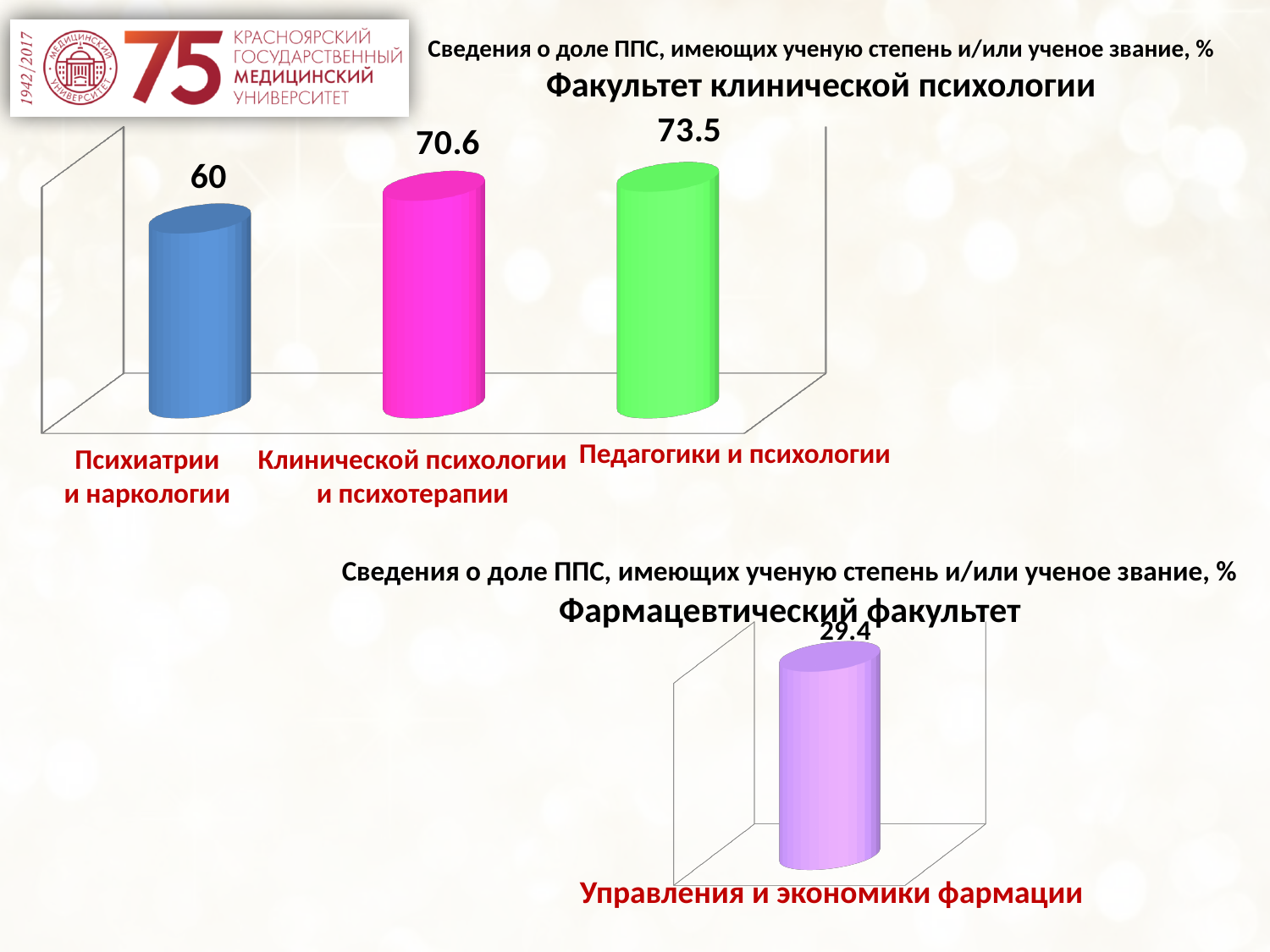
In the chart titled "Фармацевтический факультет", what is the value for Управления и экономики фармации? 29.4 In the chart titled "Факультет клинической психологии", which is larger: the value for Клинической психологии и психотерапии or for Психиатрии и наркологии? Клинической психологии и психотерапии In the chart titled "Факультет клинической психологии", which department has the highest value? Педагогики и психологии In the chart titled "Факультет клинической психологии", do the values rise or fall from left to right? rise In the chart titled "Факультет клинической психологии", what is the value for Педагогики и психологии? 73.5 What kind of chart is the chart titled "Фармацевтический факультет"? bar chart In the chart titled "Факультет клинической психологии", which department has the lowest value? Психиатрии и наркологии In the chart titled "Факультет клинической психологии", what is the value for Психиатрии и наркологии? 60 In the chart titled "Факультет клинической психологии", how many departments are shown? 3 In the chart titled "Факультет клинической психологии", what is the difference between the values for Клинической психологии и психотерапии and Психиатрии и наркологии? 10.6 In the chart titled "Факультет клинической психологии", what is the difference between the values for Педагогики и психологии and Психиатрии и наркологии? 13.5 In the chart titled "Факультет клинической психологии", what is the value for Клинической психологии и психотерапии? 70.6